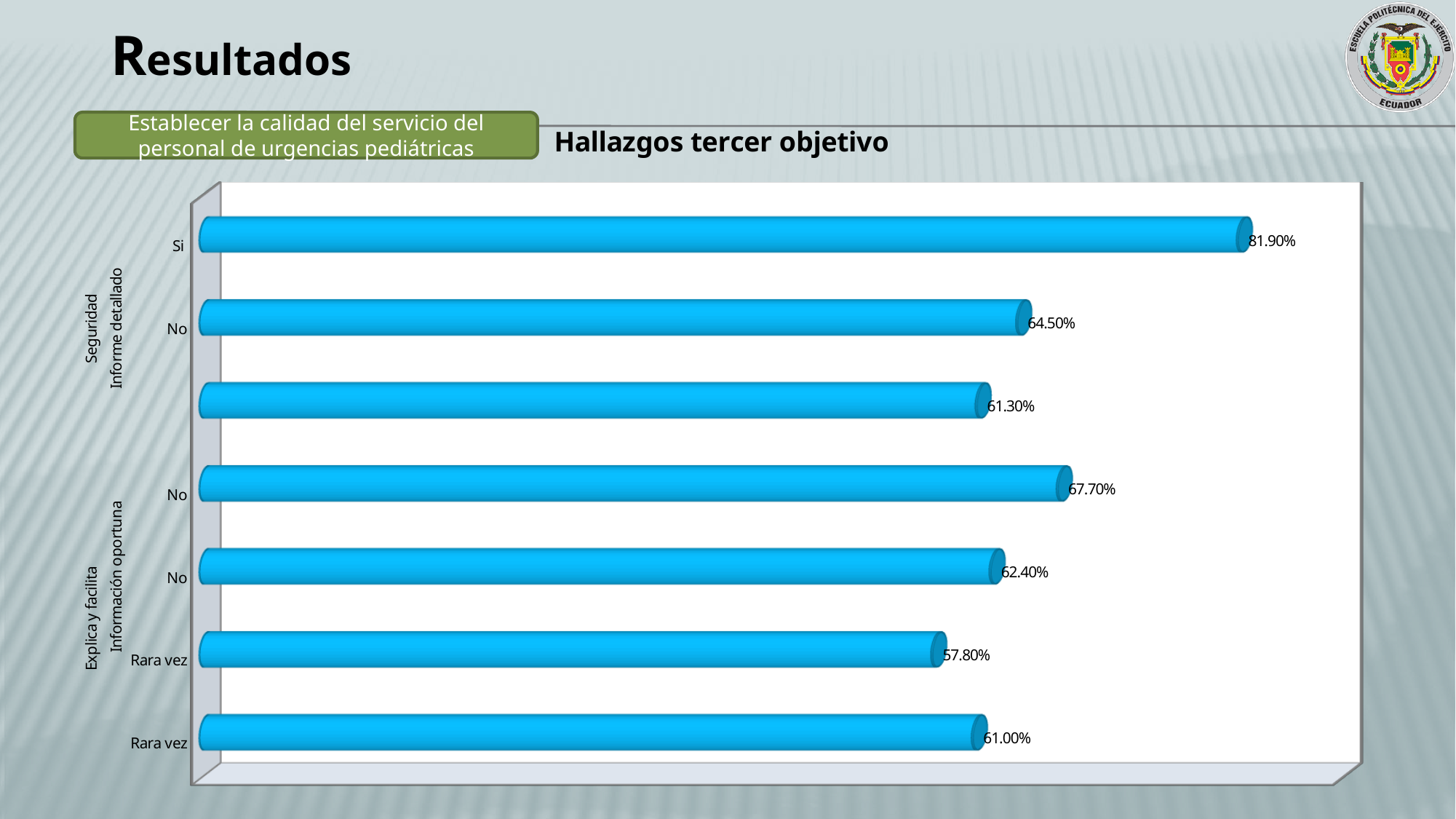
What is the lowest value shown in the chart? 57.80% How many bars are plotted in the chart? 7 Of the two bars labelled "Rara vez", which has the larger value, the upper one or the lower one? the lower one What is the value of the topmost bar in the chart? 81.90% What is the difference between the highest value (81.90%) and the lowest value (57.80%) in the chart? 24.10% What type of chart is shown on the slide? bar chart What is the heading printed to the right of the green box above the chart? Hallazgos tercer objetivo What is the value of the bottom bar, labelled "Rara vez"? 61.00% What is the value of the bar labelled "Si"? 81.90% Which bar has the highest value in the chart? Si What is the value of the third bar from the top? 61.30% What is the difference between the "Si" bar (81.90%) and the bar directly below it (64.50%)? 17.40%